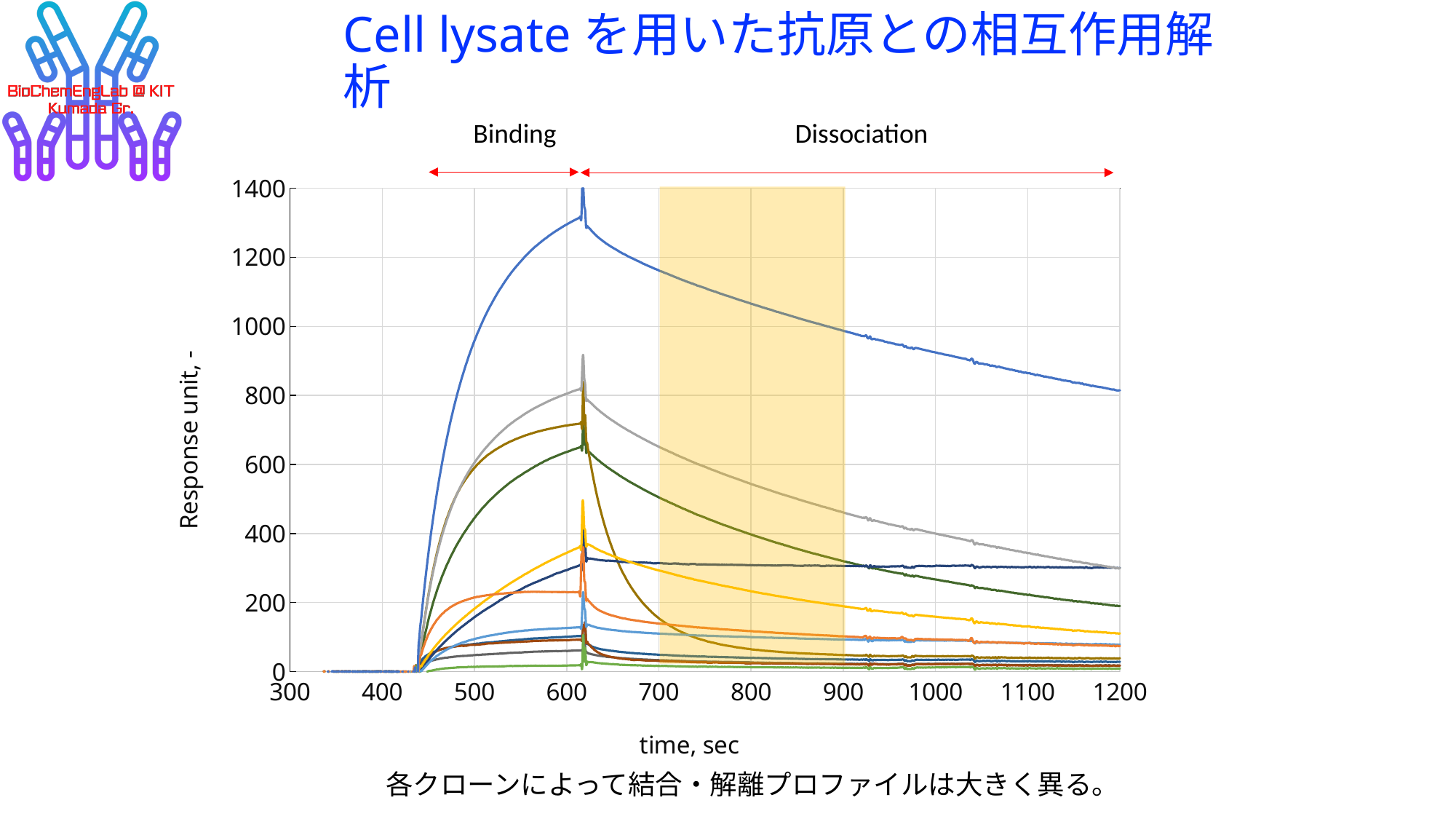
Is the peak value of the highest (blue) line greater or less than 1200? greater Do the lines rise or fall between time 450 sec and 600 sec? rise Is the value of the highest (blue) line at time 700 sec greater or less than 1000? greater What is the title of the vertical axis of the chart? Response unit, - What two phases are labelled above the chart? Binding and Dissociation Is the value of the grey line at time 800 sec greater or less than 400? greater Does the highest (blue) line rise or fall between time 700 sec and 1200 sec? fall What kind of chart is shown on the slide? line chart Which colour line reaches the highest response unit value in the chart? blue